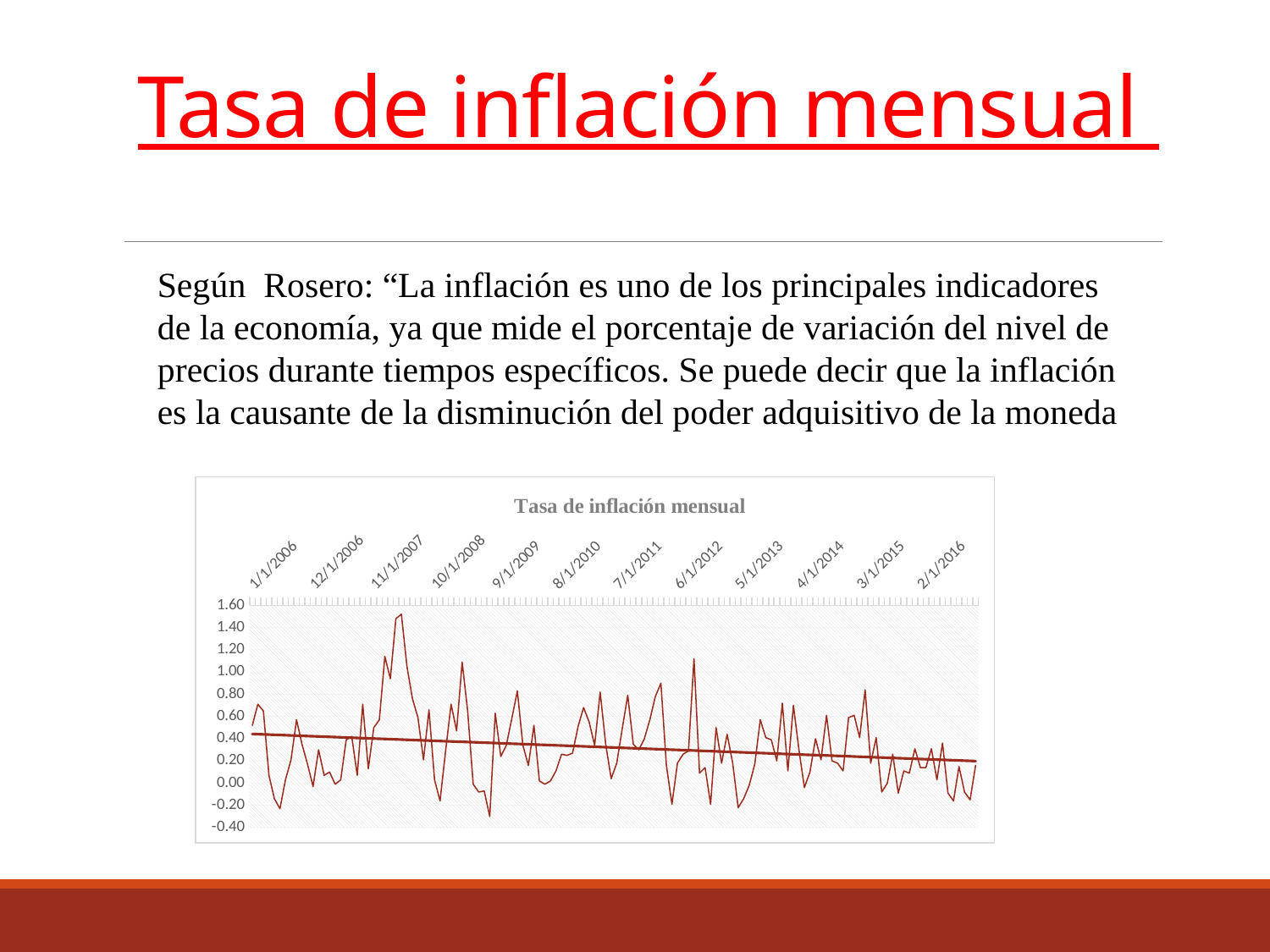
How many date labels are printed along the x axis of the chart? 12 Is the value of the trend line at the right end of the chart (around 2/1/2016) greater or less than 0.40? less What is the highest value shown on the chart's vertical axis? 1.60 Is the lowest point of the monthly inflation line greater or less than -0.20? less What is the lowest value shown on the chart's vertical axis? -0.40 Does the straight trend line on the chart rise or fall from left to right? fall What is the first date label shown on the x axis of the chart? 1/1/2006 What kind of chart is shown on the slide? line chart What is the title of the chart? Tasa de inflación mensual What is the last date label shown on the x axis of the chart? 2/1/2016